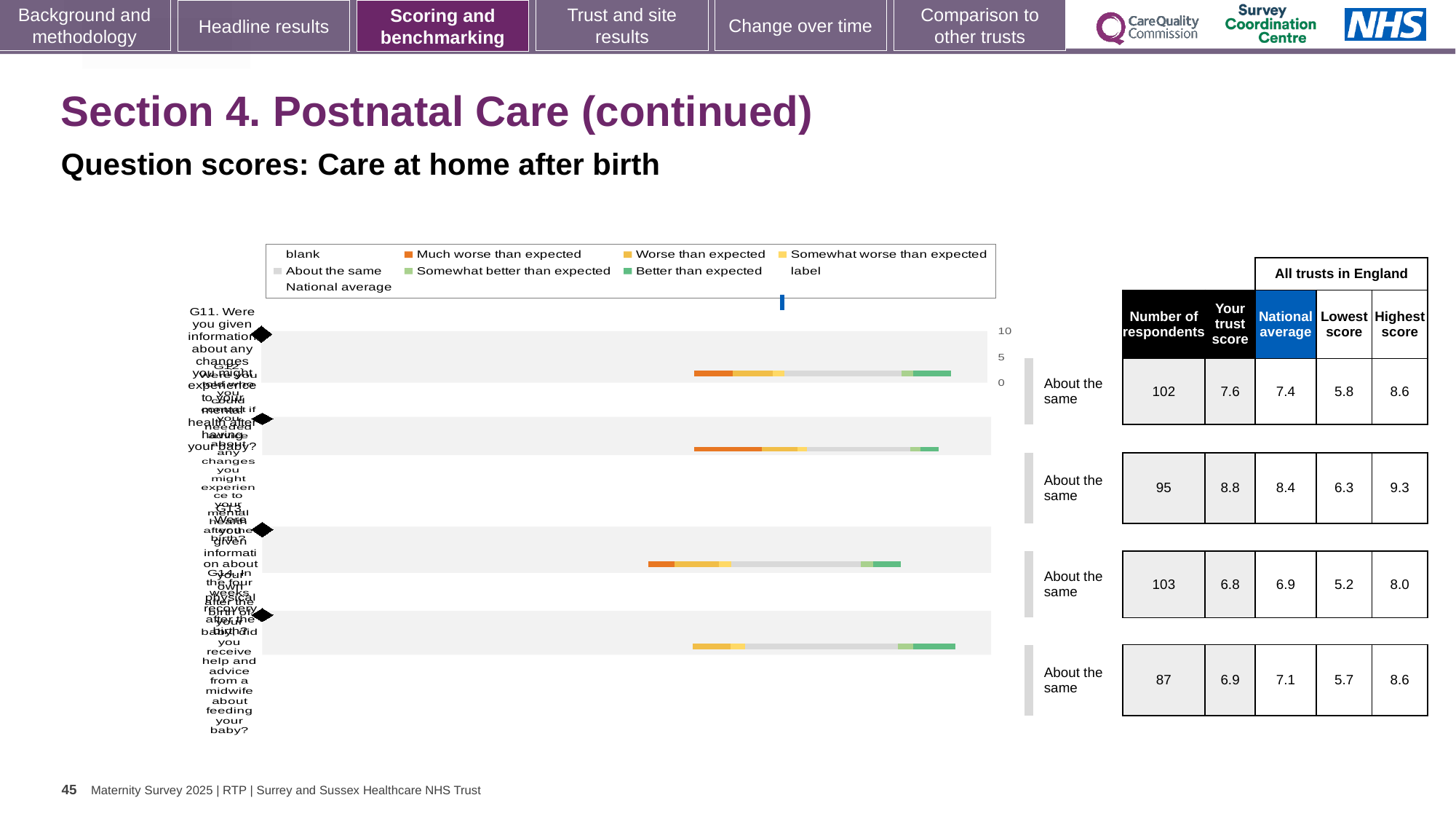
Which row of the table has the lowest number of respondents? the fourth row (87) In the table, what is the 'Your trust score' value for the second row? 8.8 In the table, what is the national average for the third row? 6.9 How many question rows (bars) are plotted in the chart? 4 In the table, what is the highest score for the fourth row? 8.6 In the second row of the table, which is larger: the trust score or the national average? the trust score (8.8) What benchmark category is shown next to each of the four bars? About the same What colour is used in the legend for 'Much worse than expected'? orange In the first row of the table, what is the difference between the highest score and the lowest score? 2.8 Which row of the table has the highest 'Your trust score'? the second row (8.8) What kind of chart is shown on the slide? bar chart In the table, what is the number of respondents for the first row? 102